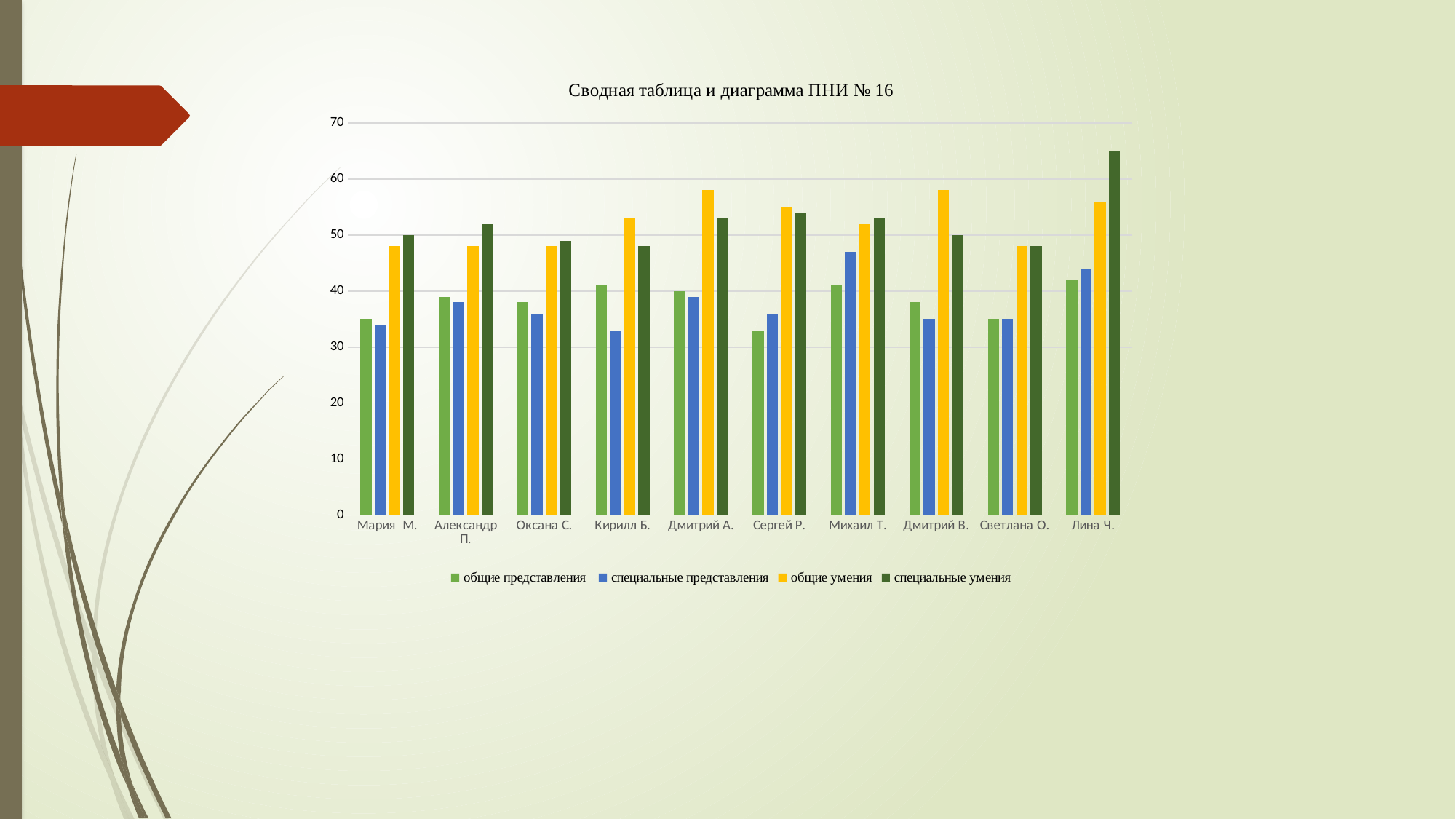
What kind of chart is shown on the slide? bar chart Which series is shown in yellow in the legend? общие умения Is the value of общие умения for Дмитрий А. greater or less than 50? greater Is the value of специальные представления for Михаил Т. greater or less than 40? greater Which person has the highest value for специальные умения? Лина Ч. How many series does the legend list? 4 Is the value of общие представления for Сергей Р. greater or less than 40? less For Дмитрий А., which is larger: общие умения or специальные умения? общие умения For Лина Ч., which is larger: общие умения or специальные умения? специальные умения How many people (categories) are shown on the x axis? 10 What is the title of the chart? Сводная таблица и диаграмма ПНИ № 16